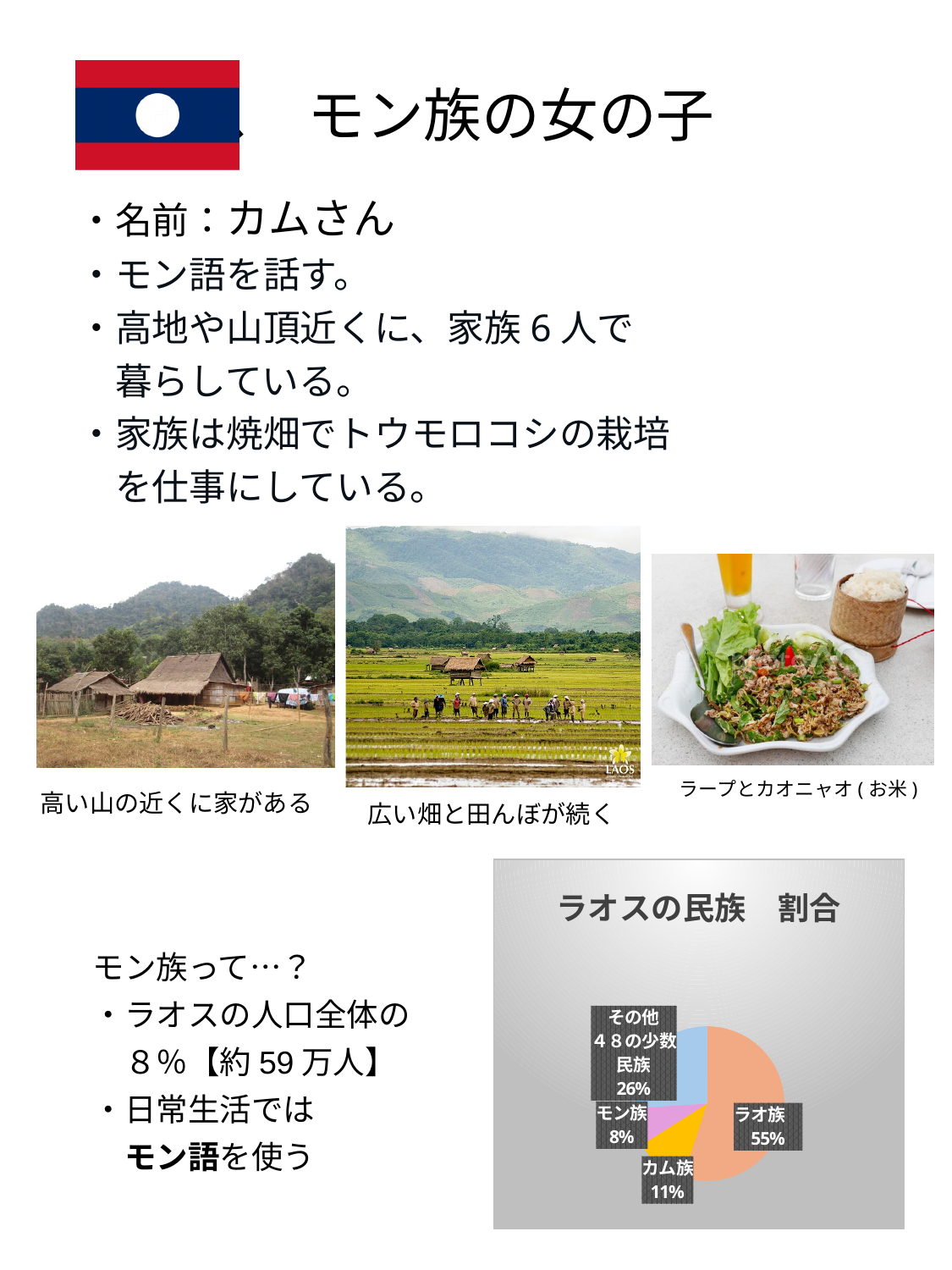
What is the title of the chart on the slide? ラオスの民族 割合 Which slice of the pie chart is the largest? ラオ族 What share of the pie does ラオ族 have? 55% Which slice of the pie chart is the smallest? モン族 What share of the pie does その他48の少数民族 have? 26% What share of the pie does カム族 have? 11% How many slices does the pie chart have? 4 What type of chart is shown under the title ラオスの民族 割合? pie chart What share of the pie does モン族 have? 8% What is the difference in percentage points between ラオ族 and その他48の少数民族? 29 Which is larger in the pie chart, カム族 or モン族? カム族 What is the difference in percentage points between カム族 and モン族? 3